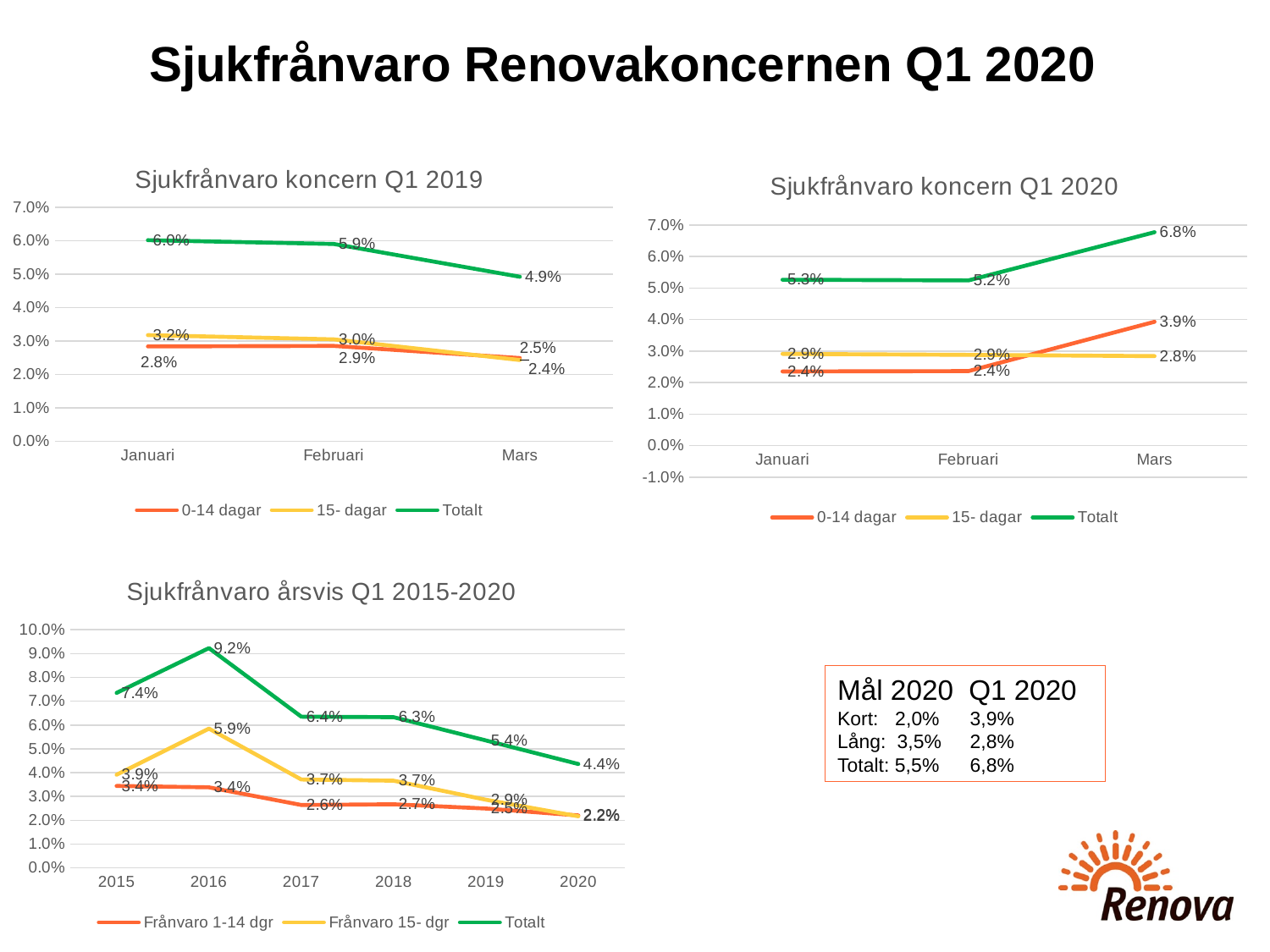
In the 'Sjukfrånvaro koncern Q1 2019' chart, does the Totalt line rise or fall from Januari to Mars? fall In the 'Sjukfrånvaro årsvis Q1 2015-2020' chart, what is the difference between the Totalt values for 2016 and 2017? 2.8% In the 'Sjukfrånvaro koncern Q1 2019' chart, what is the Totalt value for Mars? 4.9% In the 'Sjukfrånvaro koncern Q1 2020' chart, what is the difference between the Totalt values for Mars and Februari? 1.6% How many years are shown on the x axis of the 'Sjukfrånvaro årsvis Q1 2015-2020' chart? 6 In the 'Sjukfrånvaro koncern Q1 2019' chart, what is the 15- dagar value for Januari? 3.2% In the 'Sjukfrånvaro årsvis Q1 2015-2020' chart, which year has the highest Totalt value? 2016 In the 'Sjukfrånvaro årsvis Q1 2015-2020' chart, what is the Totalt value for 2020? 4.4% In the 'Sjukfrånvaro koncern Q1 2020' chart, what is the Totalt value for Mars? 6.8% What type of chart is 'Sjukfrånvaro koncern Q1 2020'? line chart In the 'Sjukfrånvaro koncern Q1 2020' chart, what is the 0-14 dagar value for Januari? 2.4% How many series does the legend of the 'Sjukfrånvaro årsvis Q1 2015-2020' chart list? 3